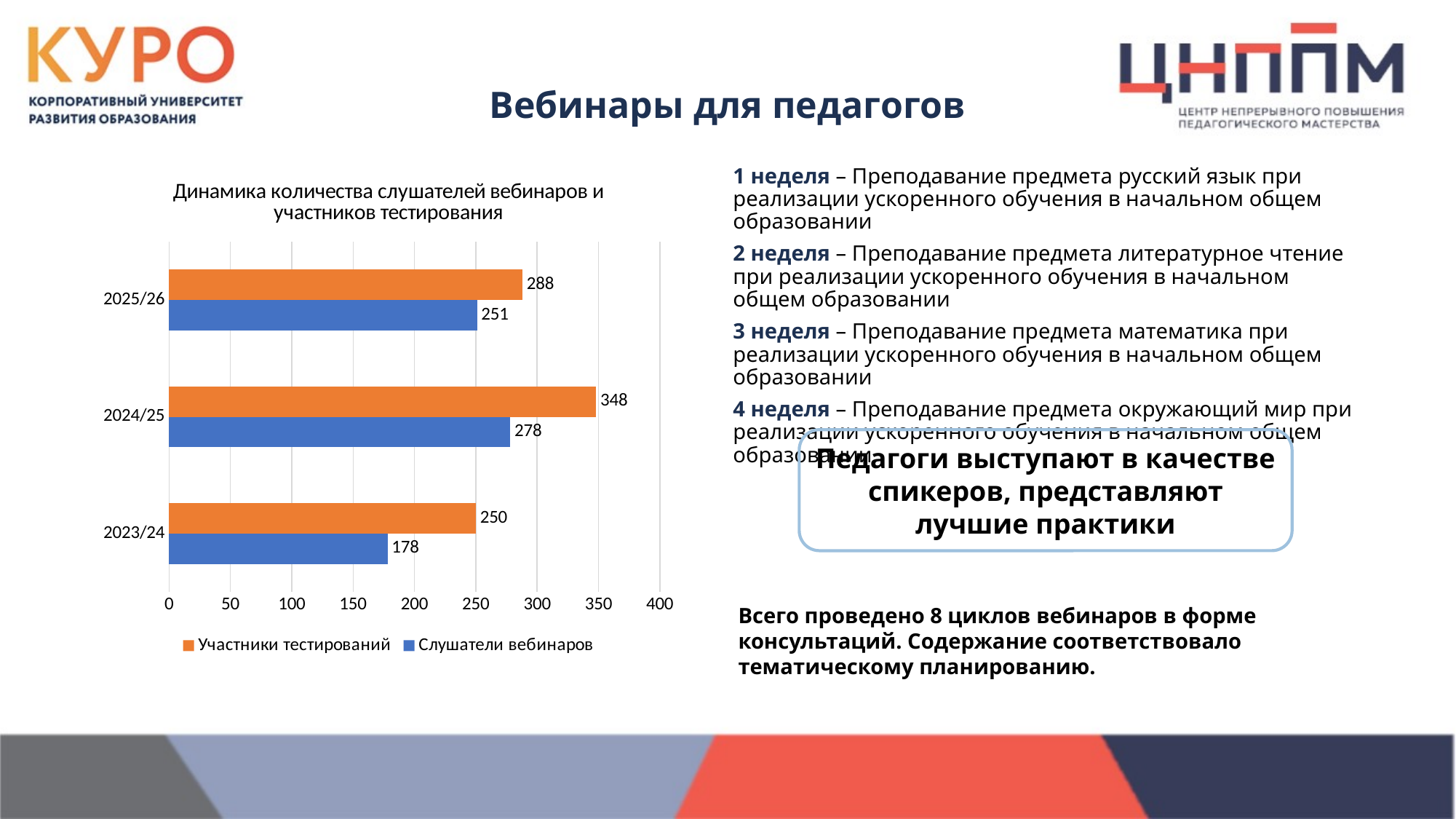
What is the value for Участники тестирований in 2024/25? 348 Which is larger in 2025/26: Участники тестирований or Слушатели вебинаров? Участники тестирований What is the title of the chart? Динамика количества слушателей вебинаров и участников тестирования What is the value for Слушатели вебинаров in 2025/26? 251 Which year has the highest value for Участники тестирований? 2024/25 What is the difference between Участники тестирований and Слушатели вебинаров in 2023/24? 72 Which year has the lowest value for Слушатели вебинаров? 2023/24 What is the difference between Участники тестирований in 2024/25 and 2025/26? 60 What kind of chart is shown on the slide? Bar chart What is the value for Слушатели вебинаров in 2023/24? 178 How many series does the legend list? 2 How many years (categories) are shown on the chart? 3